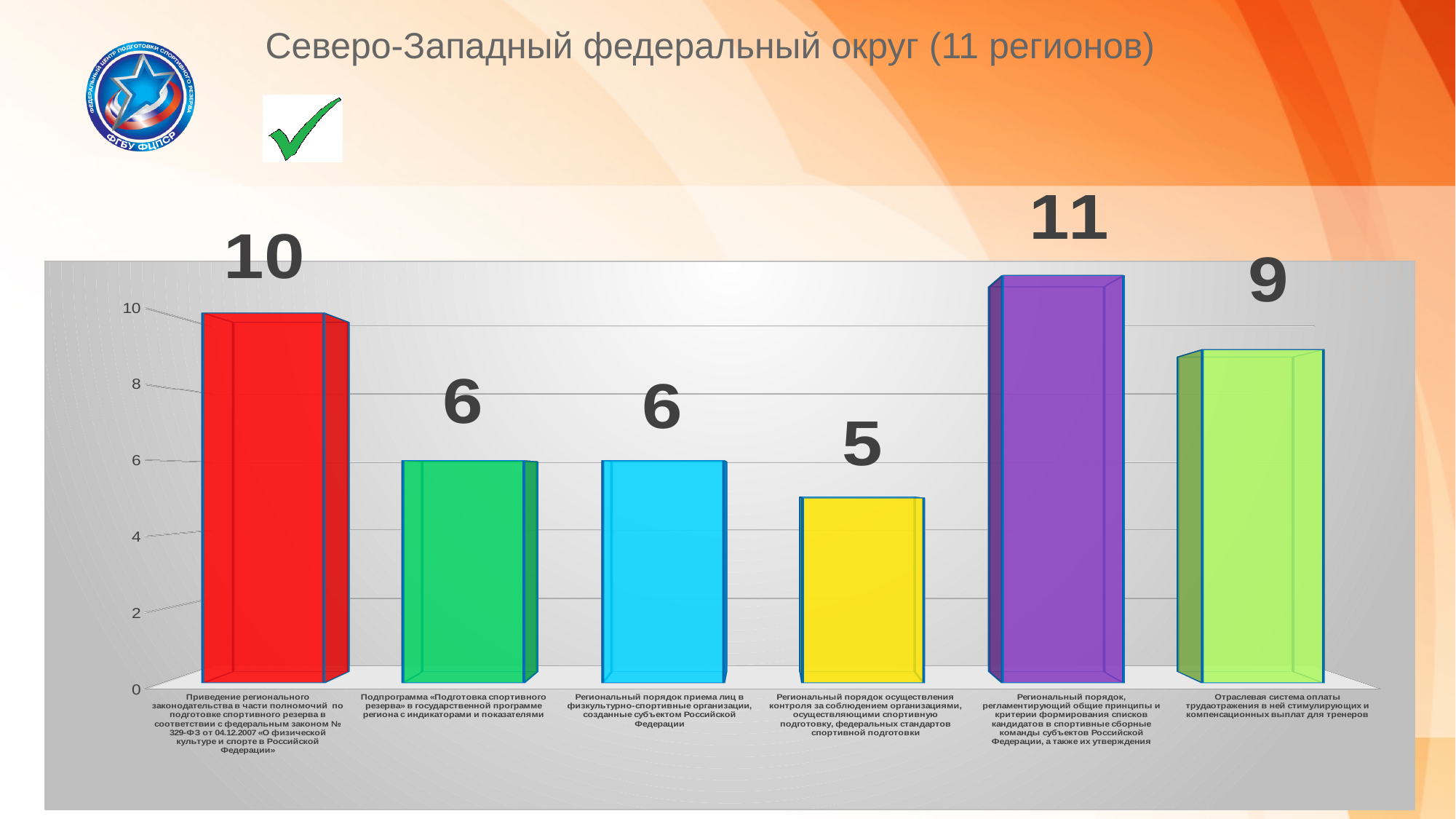
What is the difference between the value for «Приведение регионального законодательства...» (10) and the value for «Региональный порядок приема лиц в физкультурно-спортивные организации...» (6)? 4 Which category has the highest value? Региональный порядок, регламентирующий общие принципы и критерии формирования списков кандидатов в спортивные сборные команды субъектов Российской Федерации, а также их утверждения How many bars (categories) does the chart contain? 6 What is the value for the category «Отраслевая система оплаты труда, отражения в ней стимулирующих и компенсационных выплат для тренеров»? 9 What is the value for the category «Региональный порядок осуществления контроля за соблюдением организациями, осуществляющими спортивную подготовку, федеральных стандартов спортивной подготовки»? 5 What is the value for the category «Подпрограмма «Подготовка спортивного резерва» в государственной программе региона с индикаторами и показателями»? 6 What type of chart is shown on the slide? Bar chart Which is larger: the value for «Приведение регионального законодательства...» or the value for «Отраслевая система оплаты труда...»? Приведение регионального законодательства... What is the title of the slide containing the chart? Северо-Западный федеральный округ (11 регионов) What colour is the bar with the highest value (11)? Purple What is the difference between the highest value (11) and the lowest value (5)? 6 Which category has the lowest value? Региональный порядок осуществления контроля за соблюдением организациями, осуществляющими спортивную подготовку, федеральных стандартов спортивной подготовки